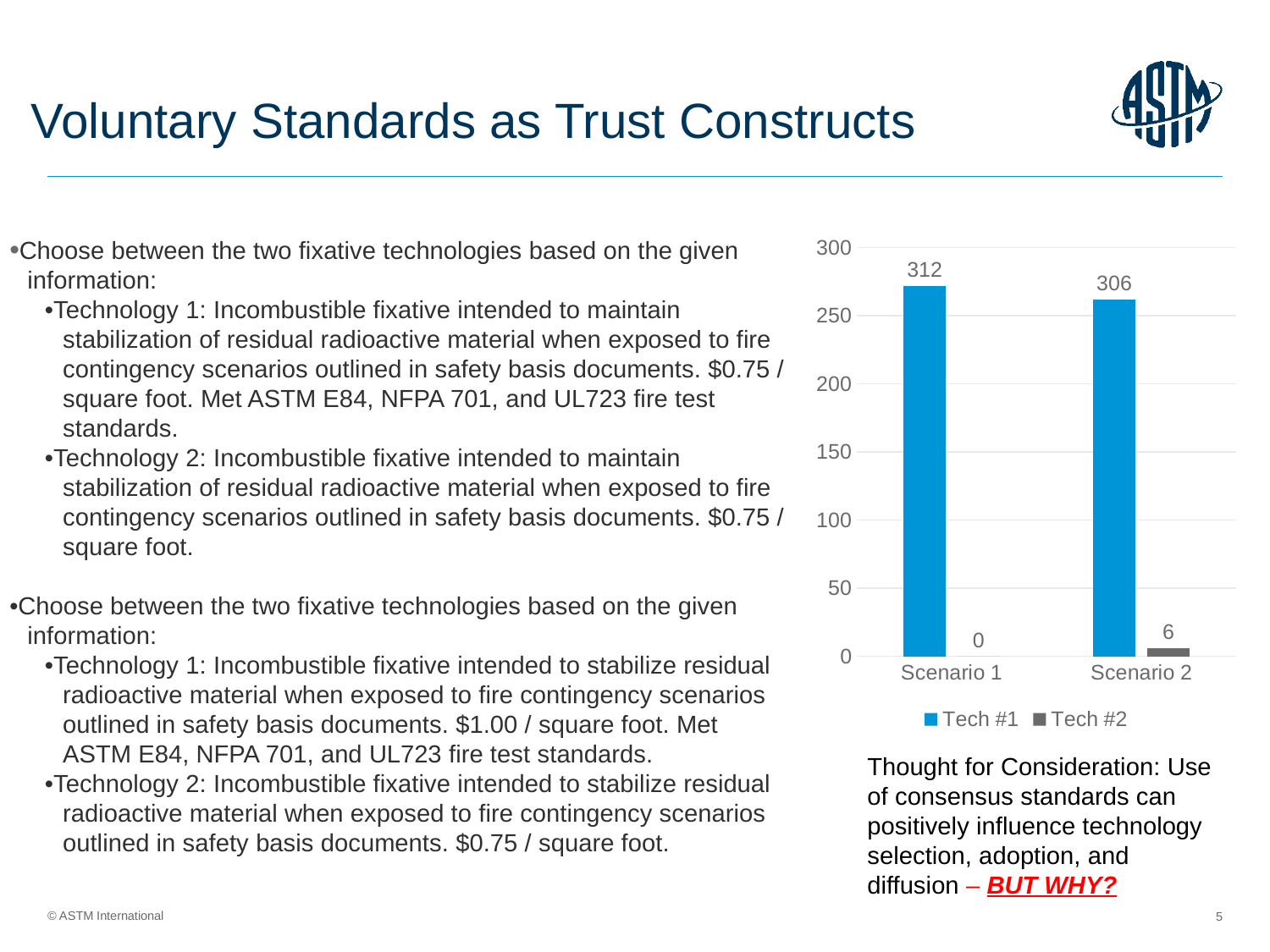
How many series does the chart legend list? 2 Which scenario has the highest value for Tech #1? Scenario 1 What is the value for Tech #1 in Scenario 2? 306 What is the value for Tech #2 in Scenario 1? 0 What is the difference between the Tech #1 values for Scenario 1 and Scenario 2? 6 What is the value for Tech #1 in Scenario 1? 312 What is the value for Tech #2 in Scenario 2? 6 How many scenarios are shown on the x axis of the chart? 2 Is the value for Tech #1 in Scenario 2 greater or less than 250? greater What kind of chart is shown on the slide? Bar chart Which scenario has the lowest value for Tech #2? Scenario 1 In Scenario 2, which series has the larger value, Tech #1 or Tech #2? Tech #1